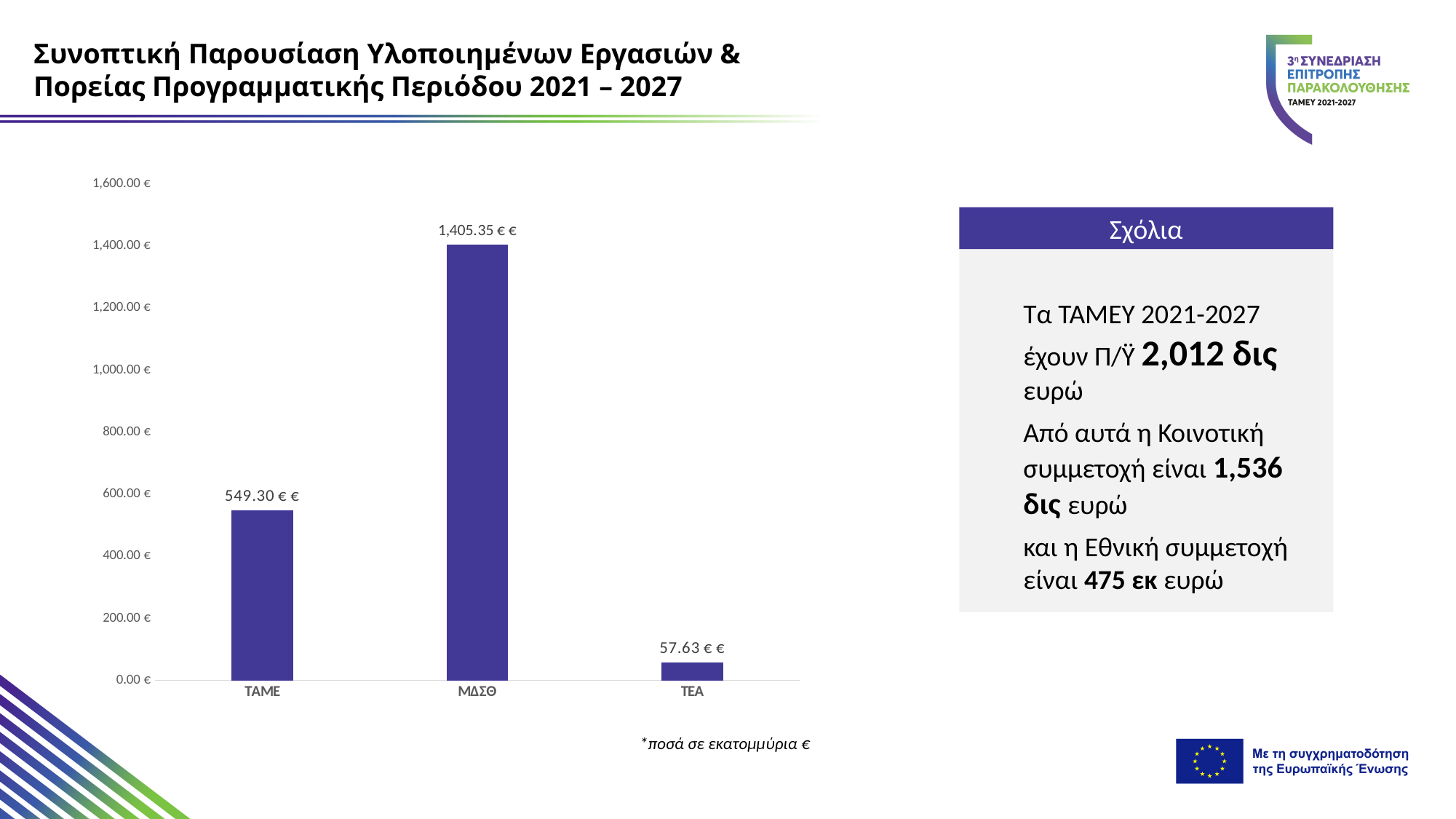
Which category has the highest value in the bar chart? ΜΔΣΘ What is the value shown for ΤΕΑ in the bar chart? 57.63 € € What is the difference between the values for ΤΑΜΕ and ΤΕΑ? 491.67 € What is the value shown for ΜΔΣΘ in the bar chart? 1,405.35 € € What kind of chart is shown on the slide? bar chart What is the value shown for ΤΑΜΕ in the bar chart? 549.30 € € What is the highest value shown on the vertical axis of the chart? 1,600.00 € Which category has the lowest value in the bar chart? ΤΕΑ How many categories are shown on the x axis of the bar chart? 3 Which is larger, the value for ΤΑΜΕ or the value for ΤΕΑ? ΤΑΜΕ Is the value for ΤΑΜΕ greater or less than 600.00 €? less What is the difference between the values for ΜΔΣΘ and ΤΑΜΕ? 856.05 €